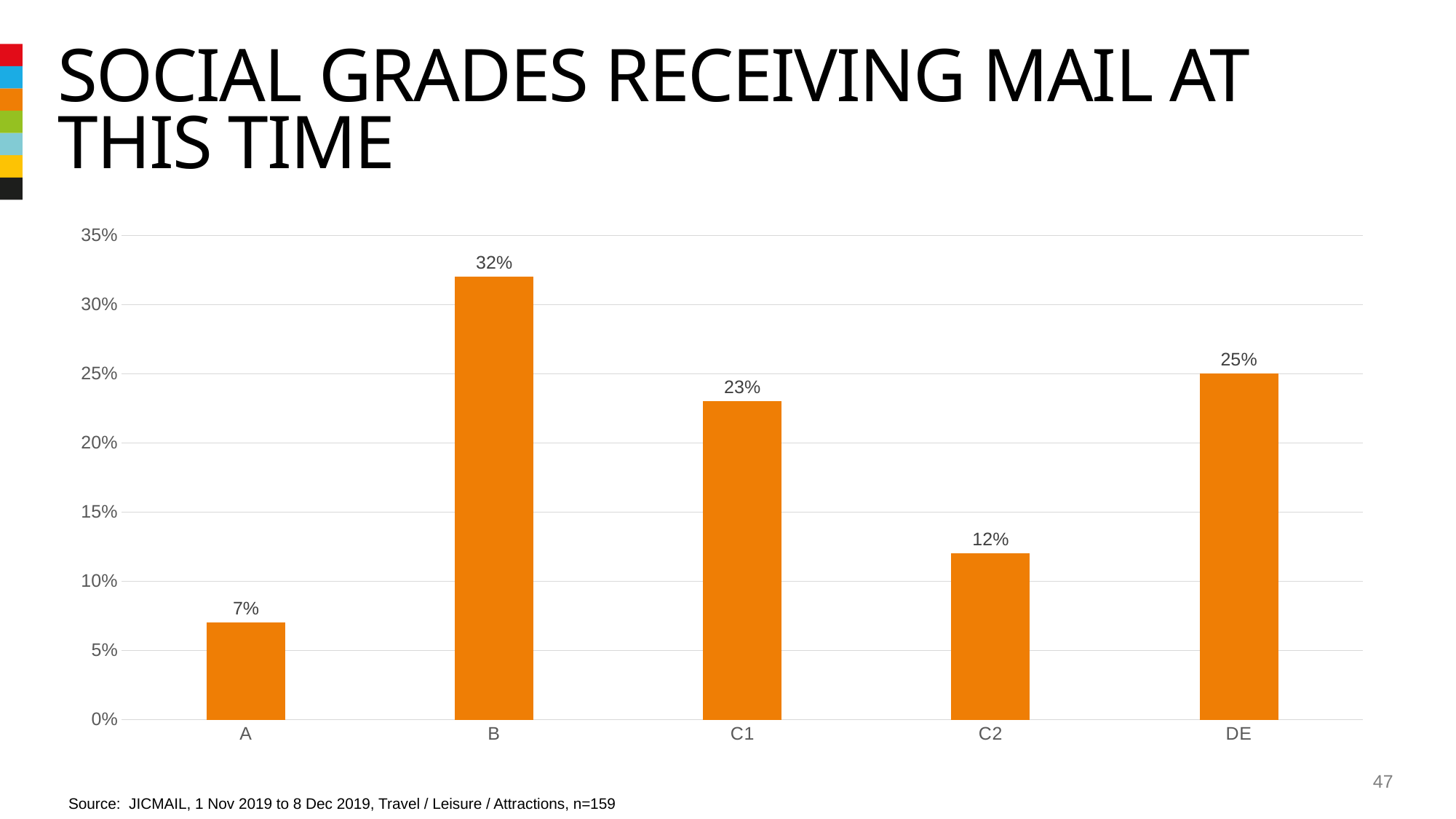
What is the value for social grade C2? 12% How many social grades are shown on the chart? 5 Is the value for C2 greater or less than 15%? less What is the title of the chart on the slide? Social grades receiving mail at this time What is the difference between the values for B and C1? 9% What is the value for social grade DE? 25% Which social grade has the lowest value? A What kind of chart is shown on the slide? Bar chart What is the difference between the values for DE and A? 18% Which social grade has the highest value? B Which is larger, the value for C1 or the value for DE? DE What is the value for social grade B? 32%